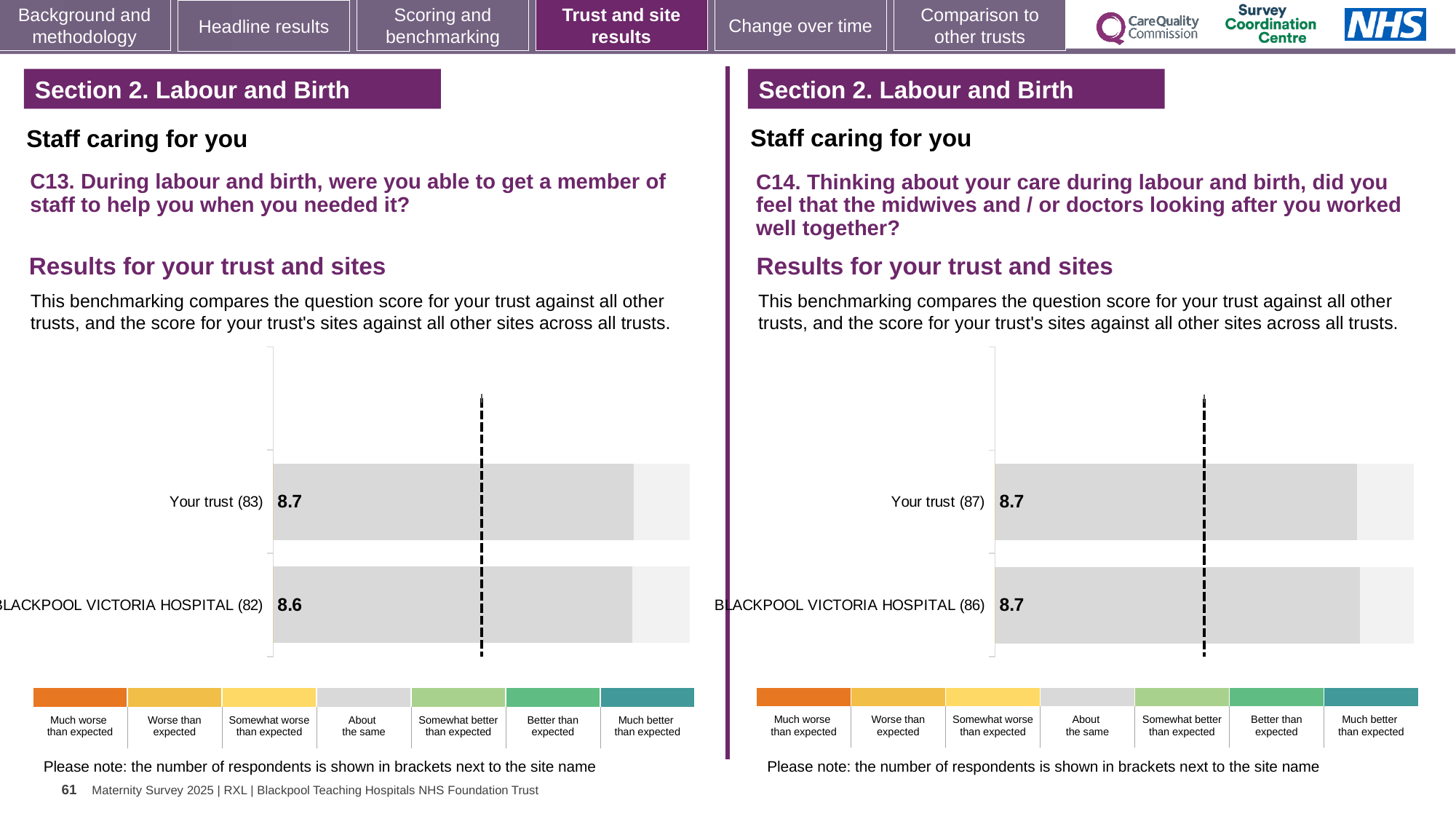
What type of chart is used in the C14 chart on the right? Bar chart In the C13 chart on the left, how many respondents are shown in brackets for Your trust? 83 In the C13 chart on the left, how many bars are plotted? 2 In the C14 chart on the right, which has the lower score, Your trust or BLACKPOOL VICTORIA HOSPITAL, or are they equal? They are equal In the C13 chart on the left, what is the score for Your trust? 8.7 In the C14 chart on the right, what is the score for Your trust? 8.7 In the C13 chart on the left, which has the higher score, Your trust or BLACKPOOL VICTORIA HOSPITAL? Your trust In the C14 chart on the right, what is the score for BLACKPOOL VICTORIA HOSPITAL? 8.7 In the C14 chart on the right, how many respondents are shown in brackets for BLACKPOOL VICTORIA HOSPITAL? 86 In the C13 chart on the left, what is the difference between the Your trust score and the BLACKPOOL VICTORIA HOSPITAL score? 0.1 In the C13 chart on the left, what is the score for BLACKPOOL VICTORIA HOSPITAL? 8.6